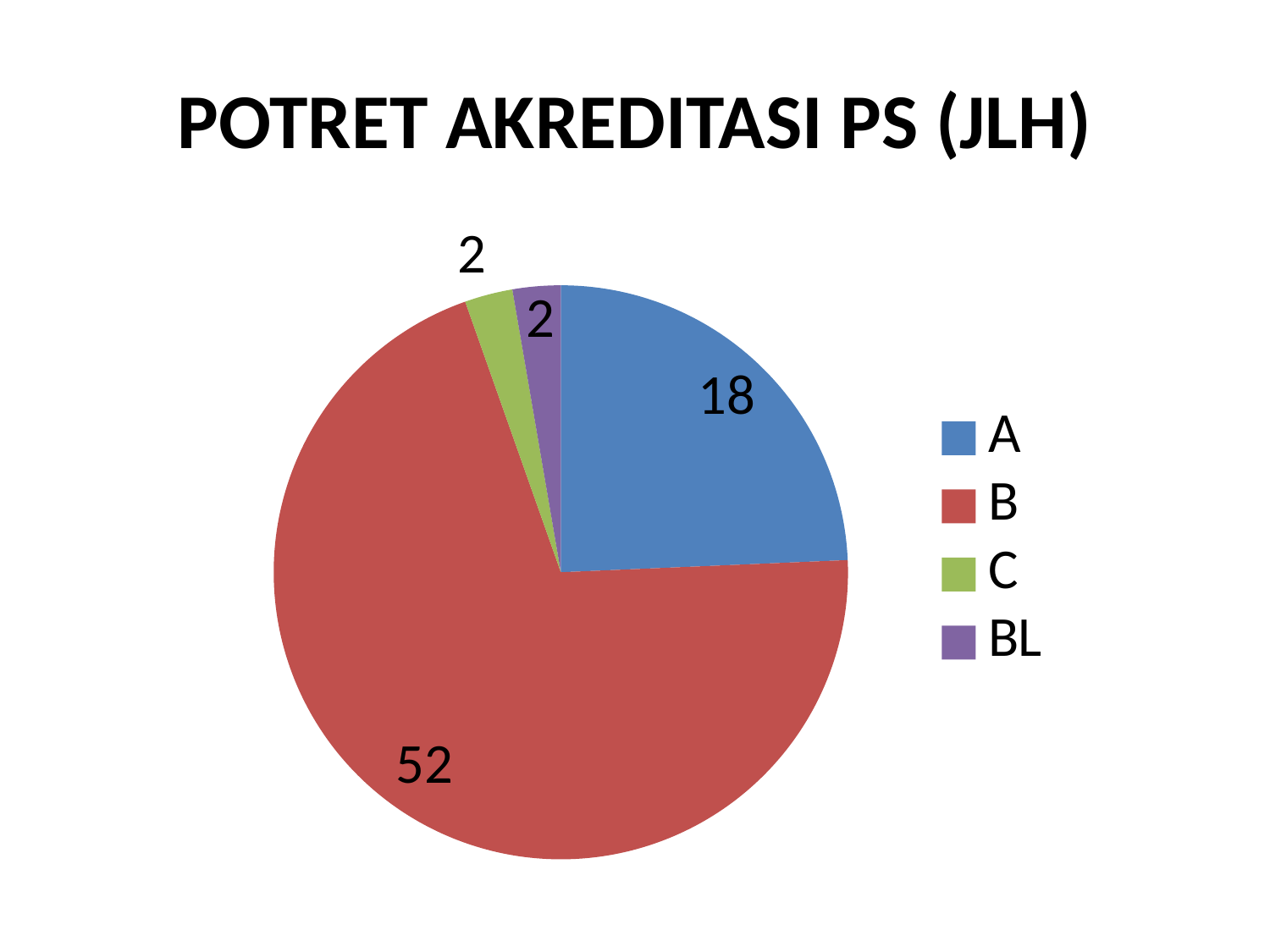
What is the value for category A in the pie chart? 18 What is the difference between the values for B and A? 34 What is the difference between the values for A and C? 16 Which is larger, the value for A or the value for B? B How many categories does the pie chart show? 4 What is the total of all the slices in the pie chart? 74 Which category has the largest slice in the pie chart? B What is the value for category BL in the pie chart? 2 What is the value for category C in the pie chart? 2 What is the title of the chart on the slide? POTRET AKREDITASI PS (JLH) What kind of chart is shown on the slide? pie chart What is the value for category B in the pie chart? 52